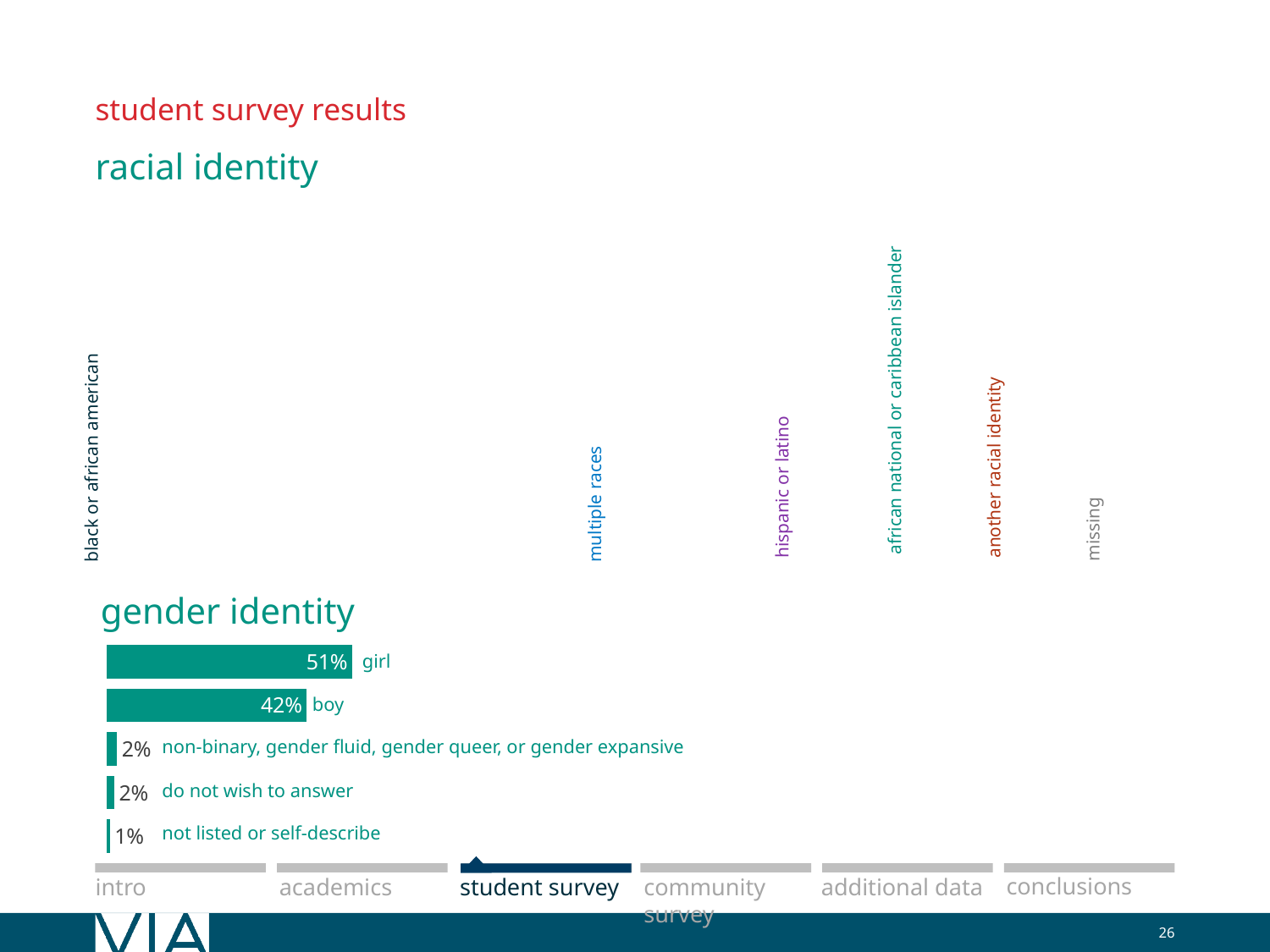
How many category labels are shown in the racial identity chart? 6 In the gender identity chart, what percentage of students identified as boy? 42% In the racial identity chart, which category label appears furthest to the left? black or african american What kind of chart is the gender identity chart? bar chart In the gender identity chart, which is larger, the value for girl or the value for boy? girl In the gender identity chart, what is the value for 'not listed or self-describe'? 1% In the gender identity chart, what percentage of students identified as girl? 51% In the gender identity chart, what is the value for 'non-binary, gender fluid, gender queer, or gender expansive'? 2% In the gender identity chart, what is the difference between the girl and boy percentages? 9% In the gender identity chart, which category has the lowest value? not listed or self-describe In the gender identity chart, which category has the highest value? girl How many categories are shown in the gender identity chart? 5